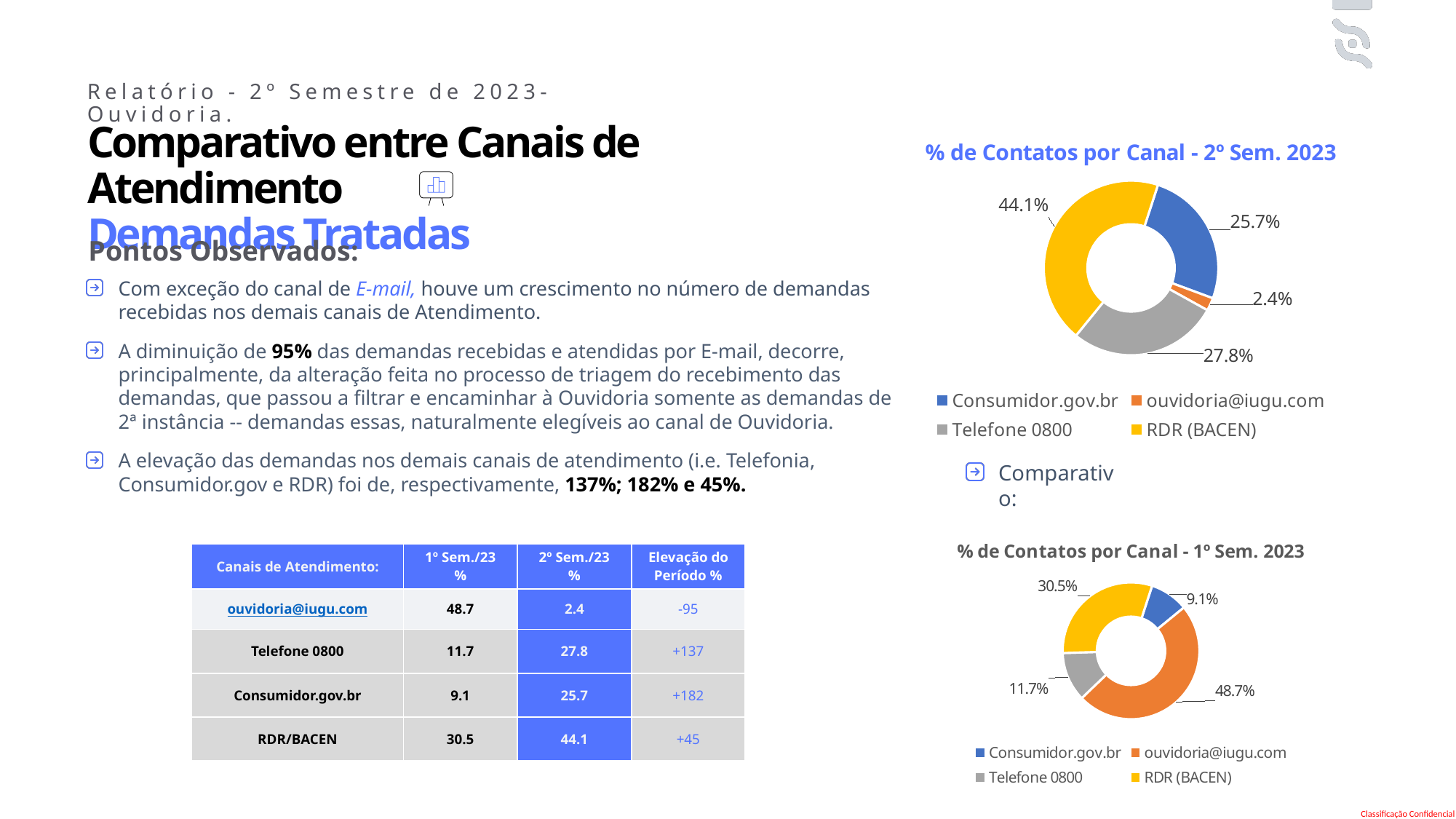
In the chart titled '% de Contatos por Canal - 2º Sem. 2023', what is the value for ouvidoria@iugu.com? 2.4% In the chart titled '% de Contatos por Canal - 1º Sem. 2023', which channel has the smallest share? Consumidor.gov.br In the chart titled '% de Contatos por Canal - 2º Sem. 2023', which channel has the smallest share? ouvidoria@iugu.com In the chart titled '% de Contatos por Canal - 1º Sem. 2023', which channel has the largest share? ouvidoria@iugu.com How many channels are shown in the chart titled '% de Contatos por Canal - 2º Sem. 2023'? 4 In the chart titled '% de Contatos por Canal - 1º Sem. 2023', which is larger: the share of RDR (BACEN) or the share of Telefone 0800? RDR (BACEN) In the chart titled '% de Contatos por Canal - 2º Sem. 2023', what is the difference between the shares of Telefone 0800 and Consumidor.gov.br? 2.1% In the chart titled '% de Contatos por Canal - 1º Sem. 2023', what is the value for ouvidoria@iugu.com? 48.7% What kind of chart is '% de Contatos por Canal - 1º Sem. 2023'? Doughnut chart In the chart titled '% de Contatos por Canal - 2º Sem. 2023', what is the value for RDR (BACEN)? 44.1% In the chart titled '% de Contatos por Canal - 2º Sem. 2023', which channel has the largest share? RDR (BACEN) In the chart titled '% de Contatos por Canal - 1º Sem. 2023', what is the value for Telefone 0800? 11.7%